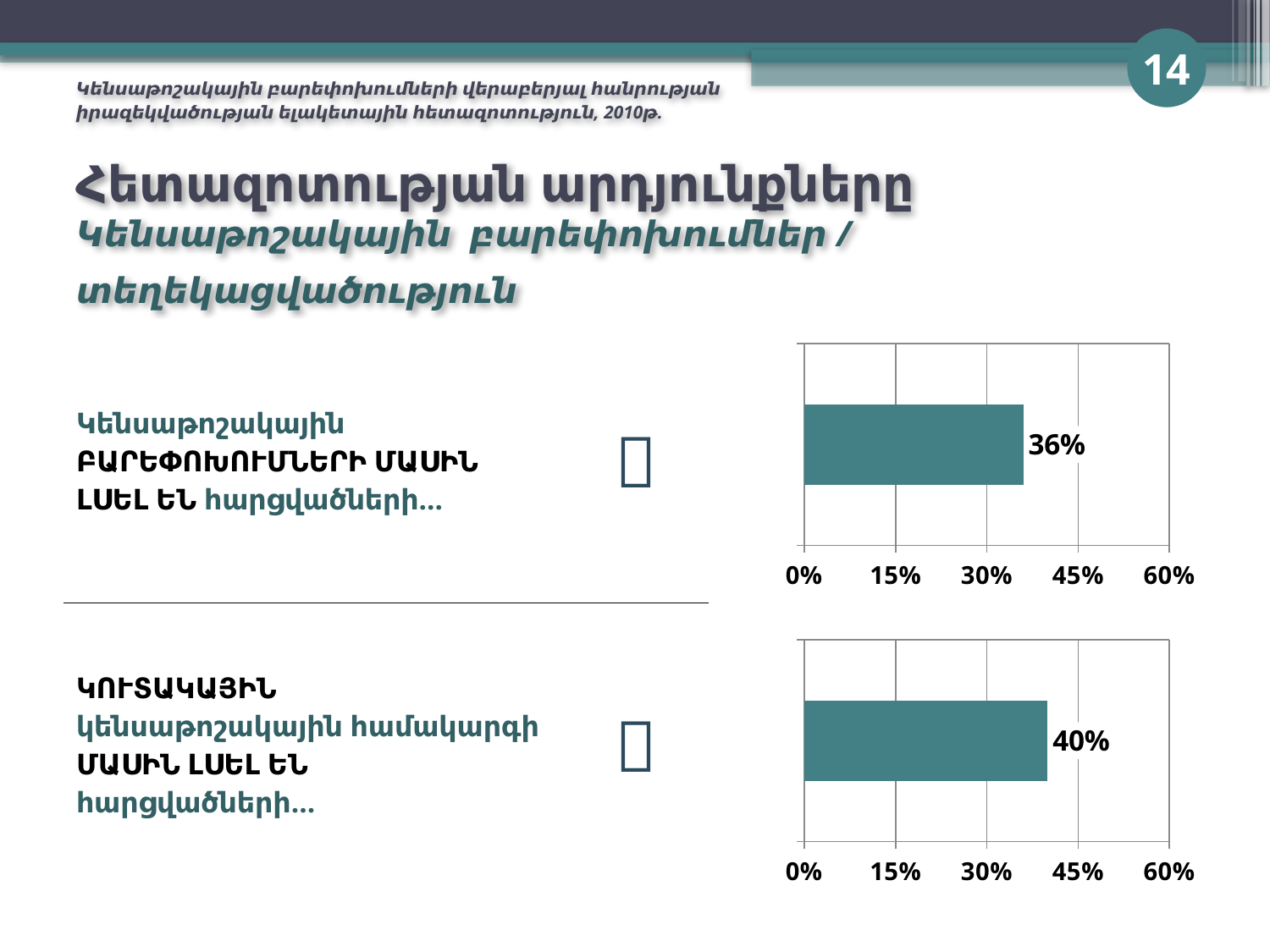
In the bottom chart, is the value of the bar greater or less than 45%? less Which chart shows the larger value, the top chart or the bottom chart? the bottom chart What colour are the bars in the two charts on the slide? teal How many bars are plotted in the bottom chart? 1 How many bar charts are shown on the slide? 2 What value is shown by the bar in the top chart on the slide? 36% What kind of chart is the top chart on the slide? bar chart What is the maximum value shown on the x axis of the top chart? 60% What value is shown by the bar in the bottom chart on the slide? 40% In the top chart, is the value of the bar greater or less than 45%? less What is the difference between the value in the bottom chart and the value in the top chart? 4% In the top chart, is the value of the bar greater or less than 30%? greater